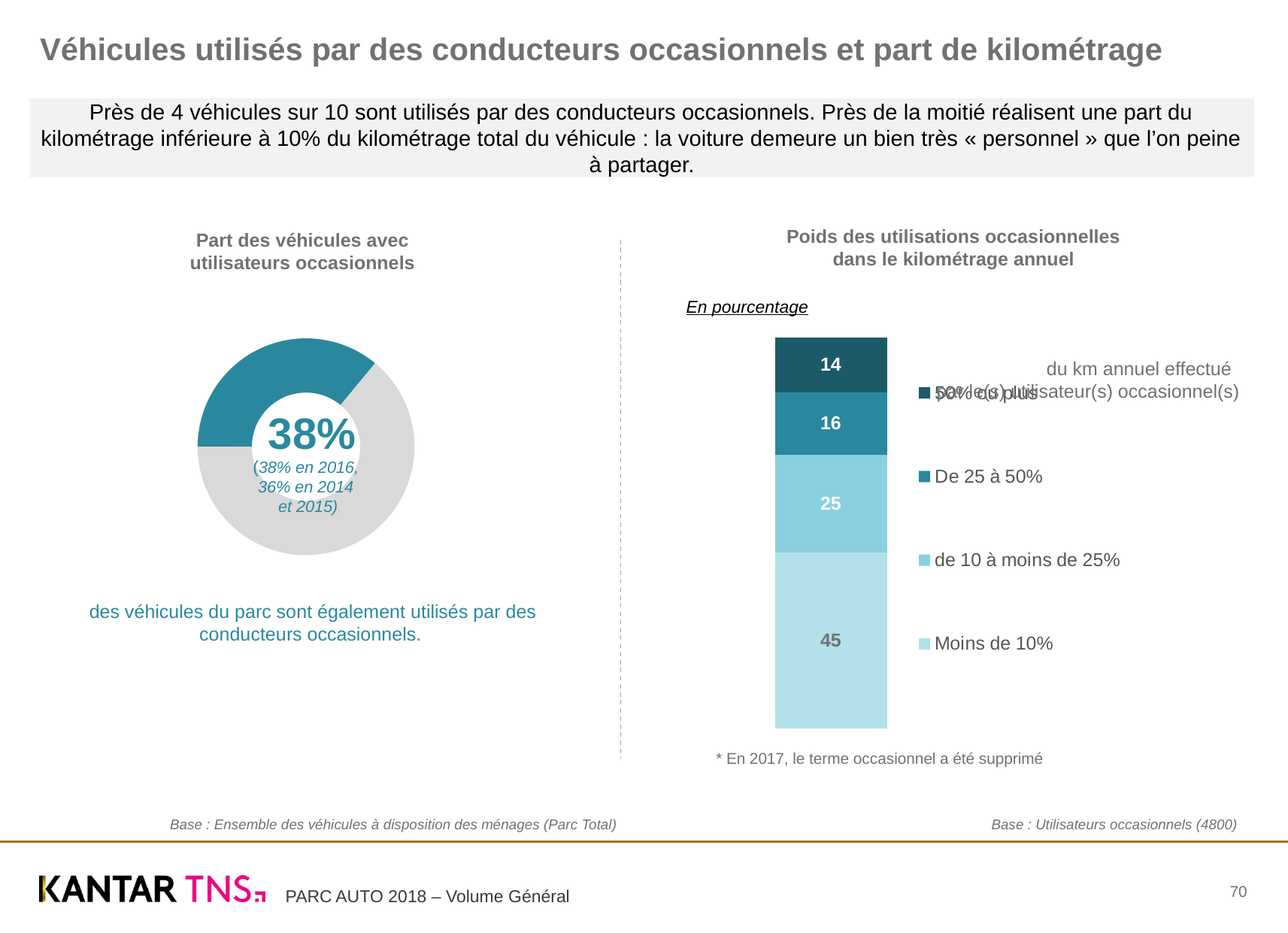
In the chart 'Poids des utilisations occasionnelles dans le kilométrage annuel', what is the difference between the values for 'Moins de 10%' and 'de 10 à moins de 25%'? 20 In the chart 'Poids des utilisations occasionnelles dans le kilométrage annuel', what is the value for 'Moins de 10%'? 45 In the chart 'Poids des utilisations occasionnelles dans le kilométrage annuel', what is the smallest value shown in the stacked bar? 14 In the chart 'Poids des utilisations occasionnelles dans le kilométrage annuel', which category has the largest value? Moins de 10% In the chart 'Poids des utilisations occasionnelles dans le kilométrage annuel', what is the total of all segments in the stacked bar? 100 What kind of chart is 'Poids des utilisations occasionnelles dans le kilométrage annuel'? Stacked bar chart In the chart 'Poids des utilisations occasionnelles dans le kilométrage annuel', which is larger: 'De 25 à 50%' or 'de 10 à moins de 25%'? de 10 à moins de 25% In the chart 'Poids des utilisations occasionnelles dans le kilométrage annuel', what is the value for 'De 25 à 50%'? 16 In the chart 'Poids des utilisations occasionnelles dans le kilométrage annuel', what is the value for 'de 10 à moins de 25%'? 25 In the chart 'Part des véhicules avec utilisateurs occasionnels', what percentage is shown in the centre of the donut? 38% What kind of chart is 'Part des véhicules avec utilisateurs occasionnels'? Donut chart In the chart 'Poids des utilisations occasionnelles dans le kilométrage annuel', how many segments make up the stacked bar? 4